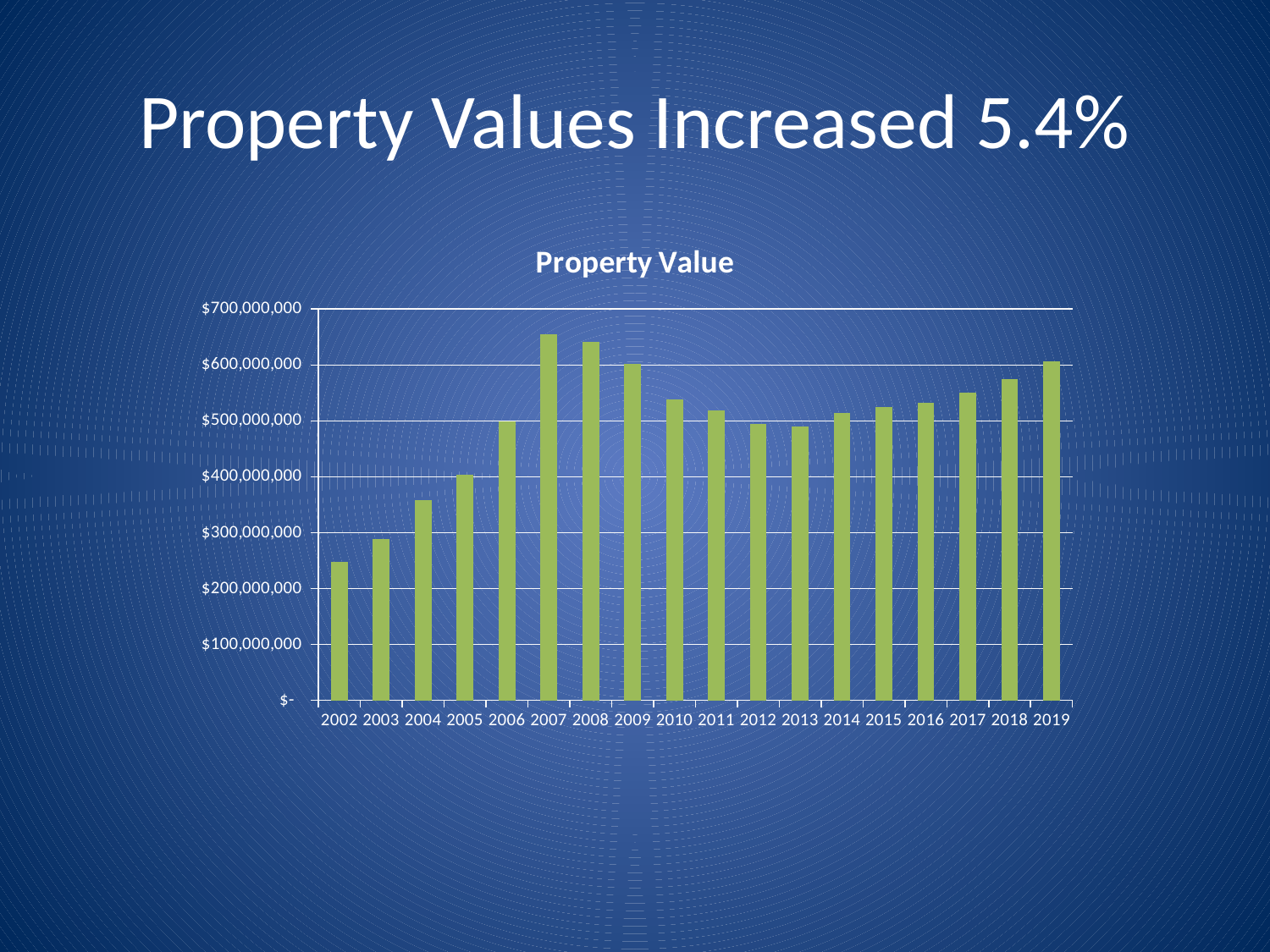
Which year has a higher property value, 2004 or 2018? 2018 Which year has the lowest property value? 2002 What kind of chart is shown on the slide? bar chart Is the property value for 2018 greater or less than $500,000,000? greater Is the property value for 2004 greater or less than $400,000,000? less Which year has a higher property value, 2007 or 2013? 2007 Is the property value for 2002 greater or less than $300,000,000? less What is the title of the chart? Property Value How many years are shown on the x axis of the chart? 18 Do property values rise or fall from 2002 to 2007? rise Which year has the highest property value? 2007